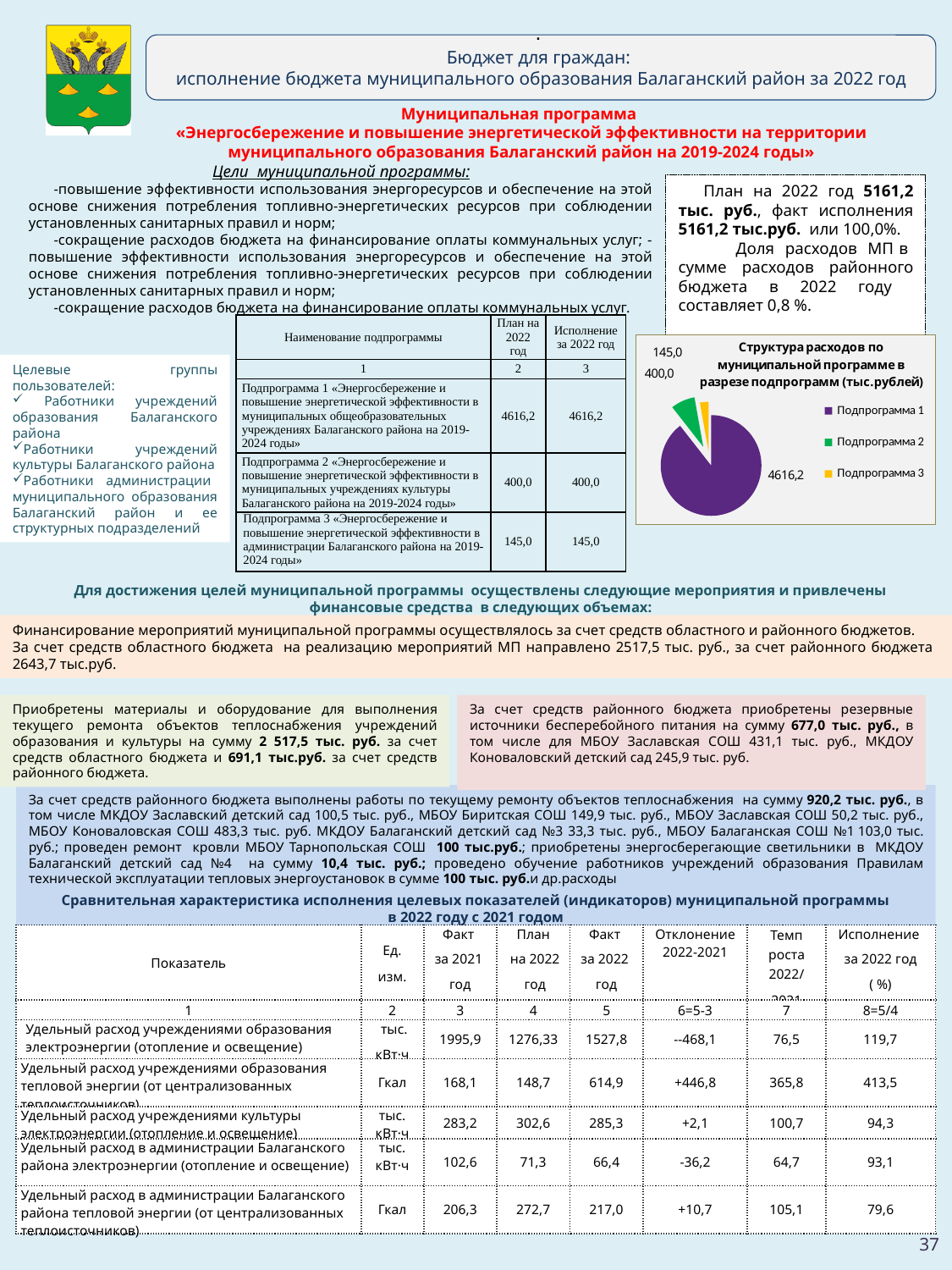
Which is larger in the pie chart, the value for Подпрограмма 2 or Подпрограмма 3? Подпрограмма 2 What is the total of all three slices in the pie chart? 5161,2 What is the value for Подпрограмма 2 in the pie chart? 400,0 What is the difference between the values for Подпрограмма 1 and Подпрограмма 2 in the pie chart? 4216,2 Which subprogram has the largest slice in the pie chart? Подпрограмма 1 What type of chart is shown on the slide? Pie chart What is the value for Подпрограмма 1 in the pie chart? 4616,2 What is the value for Подпрограмма 3 in the pie chart? 145,0 What is the title of the pie chart? Структура расходов по муниципальной программе в разрезе подпрограмм (тыс.рублей) How many entries does the legend of the pie chart list? 3 Which subprogram has the smallest slice in the pie chart? Подпрограмма 3 How many slices does the pie chart have? 3